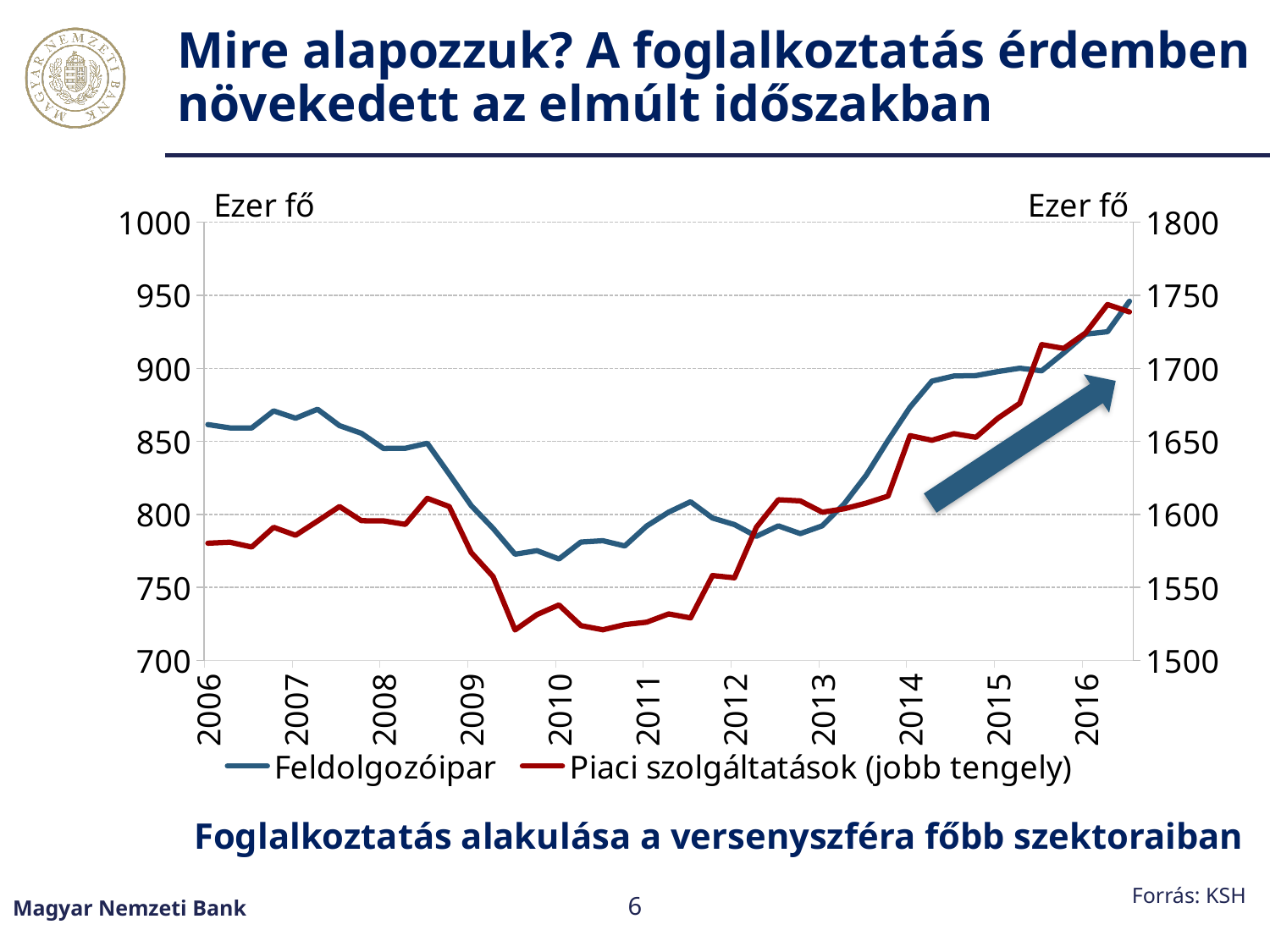
Which series is plotted on the right axis according to the legend? Piaci szolgáltatások Is the value for Piaci szolgáltatások at the start of 2016 greater or less than 1700 on the right axis? greater Does the Piaci szolgáltatások series rise or fall between 2012 and 2016? rise Is the value for Piaci szolgáltatások at the start of 2010 greater or less than 1550 on the right axis? less Is the value for Feldolgozóipar at the start of 2016 greater or less than 900? greater What kind of chart is shown on the slide? line chart Does the Feldolgozóipar series rise or fall between 2008 and 2010? fall What unit label is shown above both vertical axes? Ezer fő How many year labels are shown on the x axis? 11 How many series does the legend list? 2